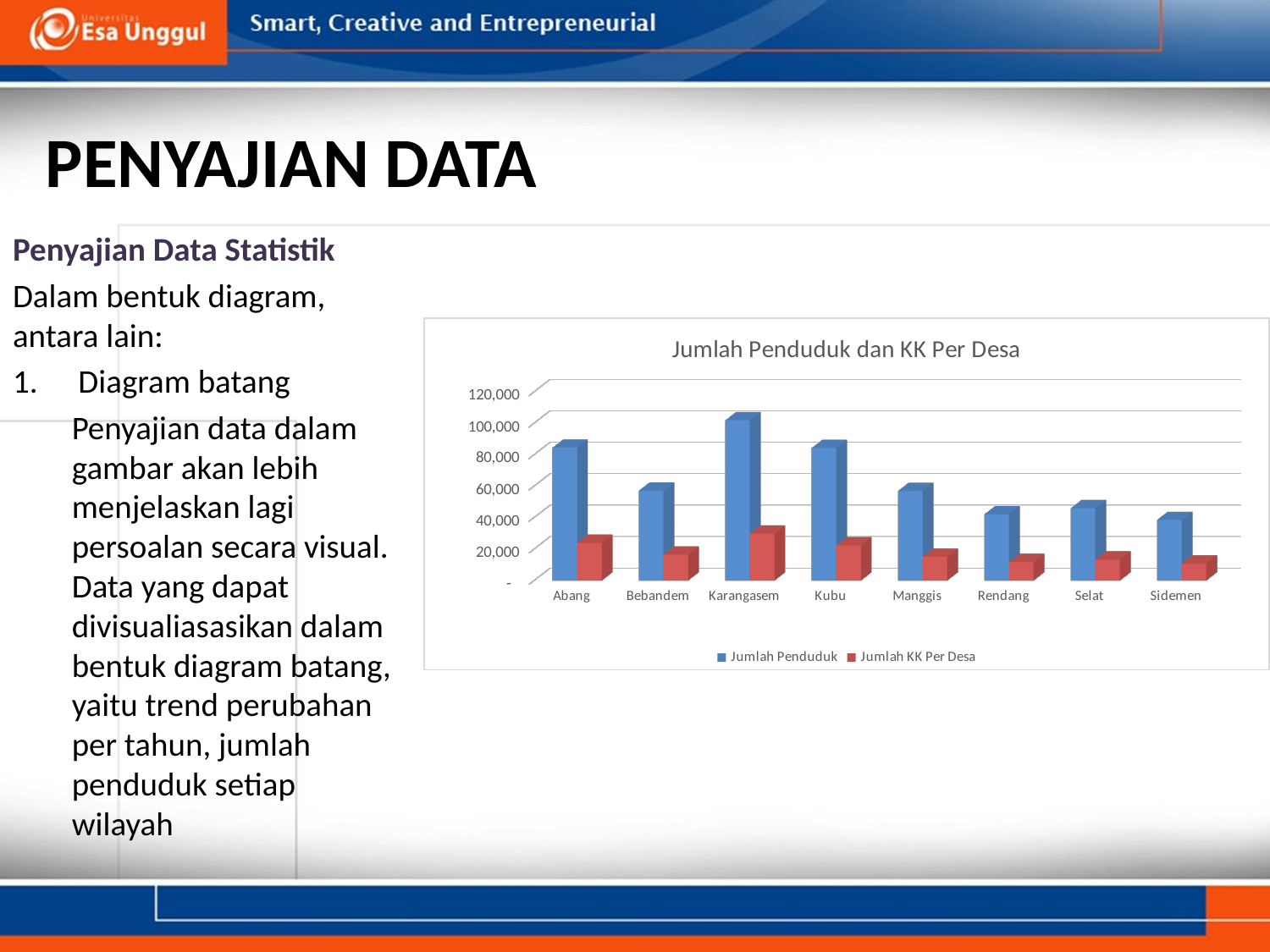
Which desa has the highest Jumlah Penduduk? Karangasem What is the title of the chart? Jumlah Penduduk dan KK Per Desa How many series does the chart legend list? 2 Is the Jumlah Penduduk for Karangasem greater or less than 80,000? greater What kind of chart is shown on the slide? Bar chart Is the Jumlah KK Per Desa for Sidemen greater or less than 20,000? less Which series is shown in red in the chart? Jumlah KK Per Desa Which desa has the highest Jumlah KK Per Desa? Karangasem Which has a larger Jumlah Penduduk, Abang or Rendang? Abang Is the Jumlah KK Per Desa for Karangasem greater or less than 20,000? greater How many desa (categories) are shown on the x axis of the chart? 8